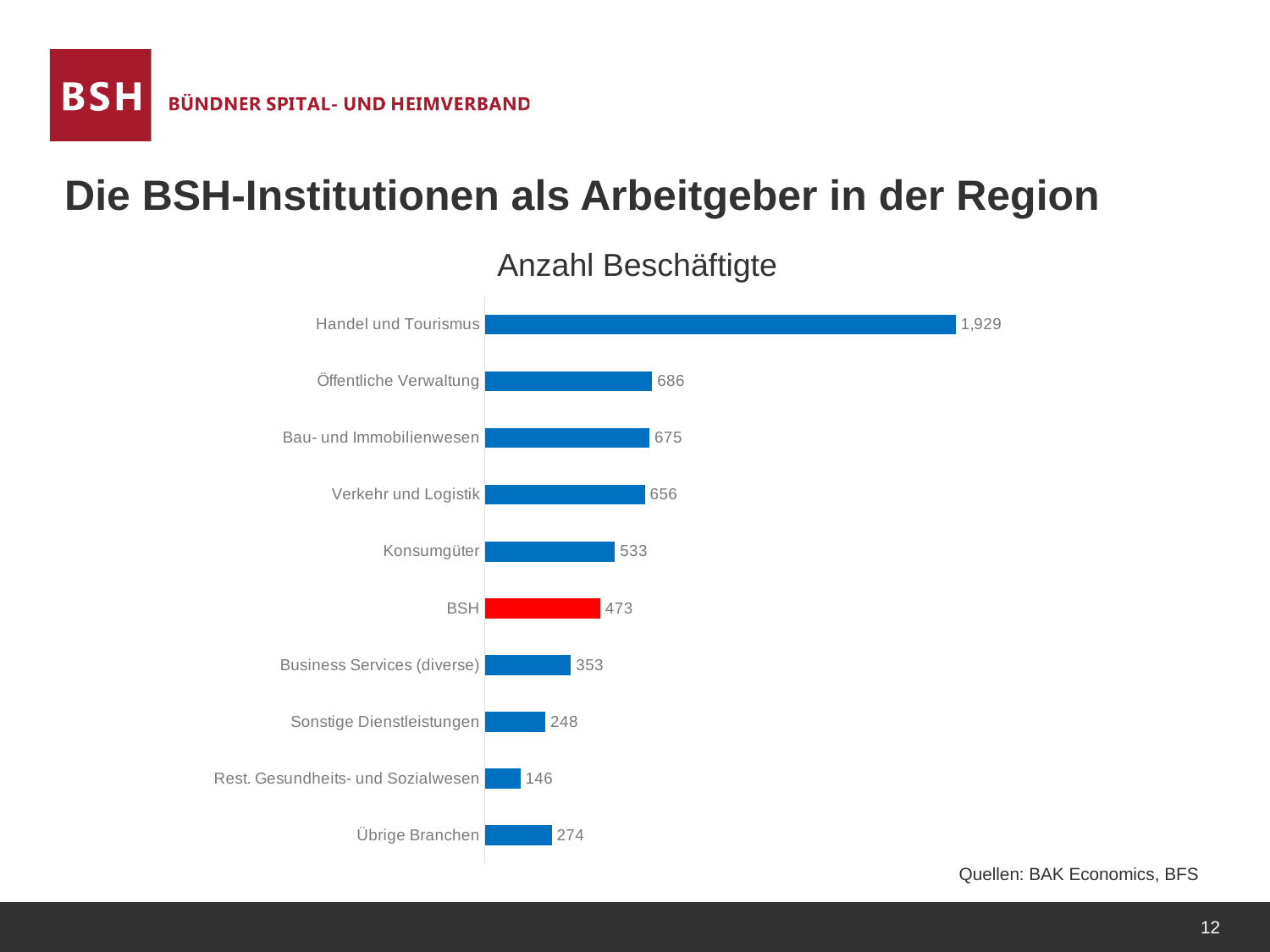
Which category has the highest number of employees? Handel und Tourismus What kind of chart is this? bar chart What is the value for BSH? 473 What is the difference between Handel und Tourismus and Konsumgüter? 1,396 Which category has the lowest number of employees? Rest. Gesundheits- und Sozialwesen Which is larger, Business Services (diverse) or Übrige Branchen? Business Services (diverse) How many categories are shown in the chart? 10 What is the title of the chart? Anzahl Beschäftigte What is the difference between Öffentliche Verwaltung and BSH? 213 Which bar is coloured red instead of blue? BSH What is the value for Rest. Gesundheits- und Sozialwesen? 146 What is the value for Handel und Tourismus? 1,929